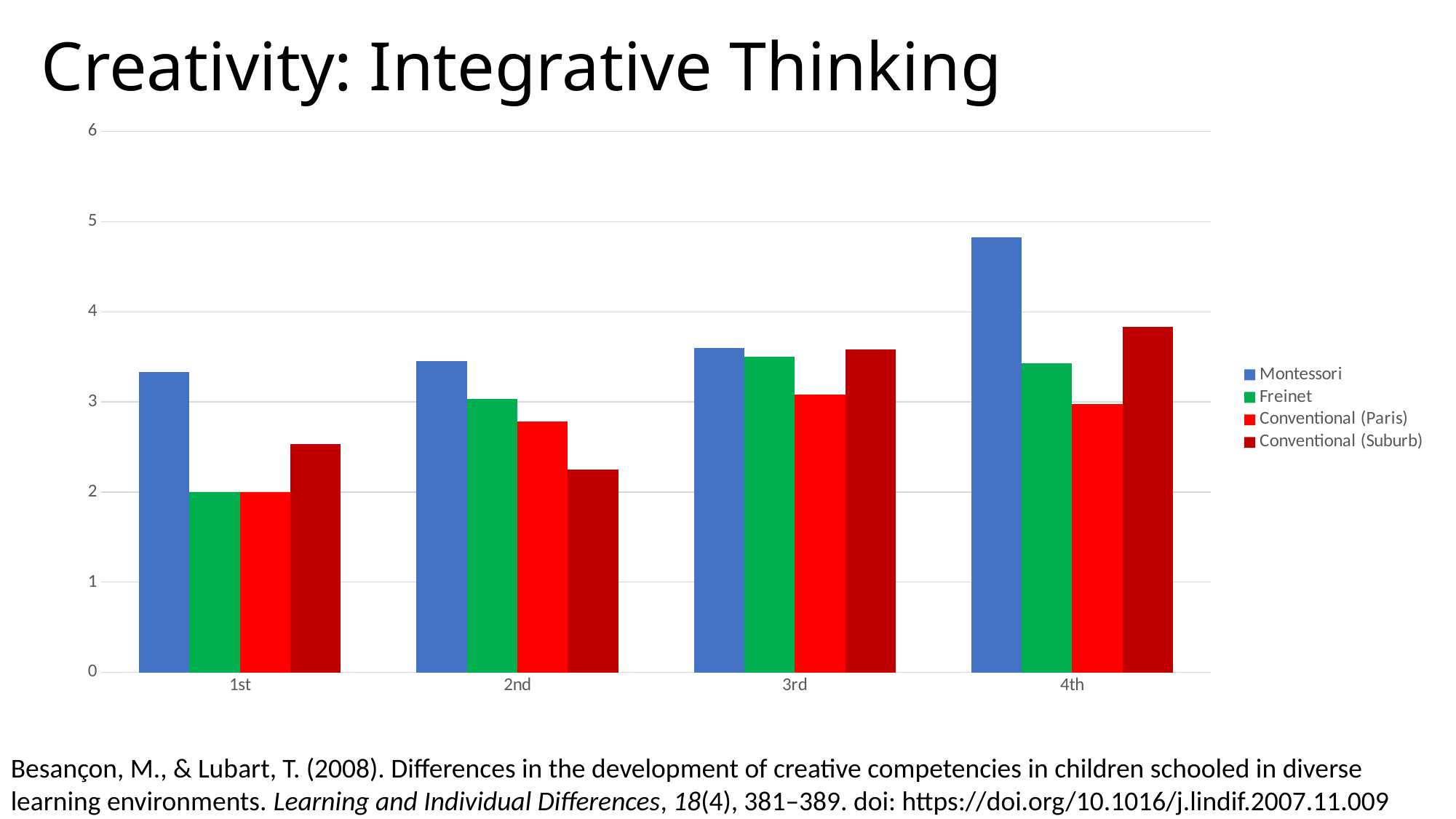
How many series does the legend list? 4 Do the Montessori values rise or fall from 1st to 4th grade? rise What kind of chart is shown on the slide? bar chart Which is larger in 4th grade: Conventional (Suburb) or Conventional (Paris)? Conventional (Suburb) Is the value for Conventional (Suburb) in 1st grade greater or less than 3? less Which is larger in 2nd grade: Montessori or Freinet? Montessori How many grade categories are shown on the x axis? 4 Which series has the highest value in the 4th grade group? Montessori Which series has the lowest value in the 2nd grade group? Conventional (Suburb) Which colour represents Freinet in the legend? green Is the value for Montessori in 4th grade greater or less than 4? greater Is the value for Freinet in 3rd grade greater or less than 3? greater